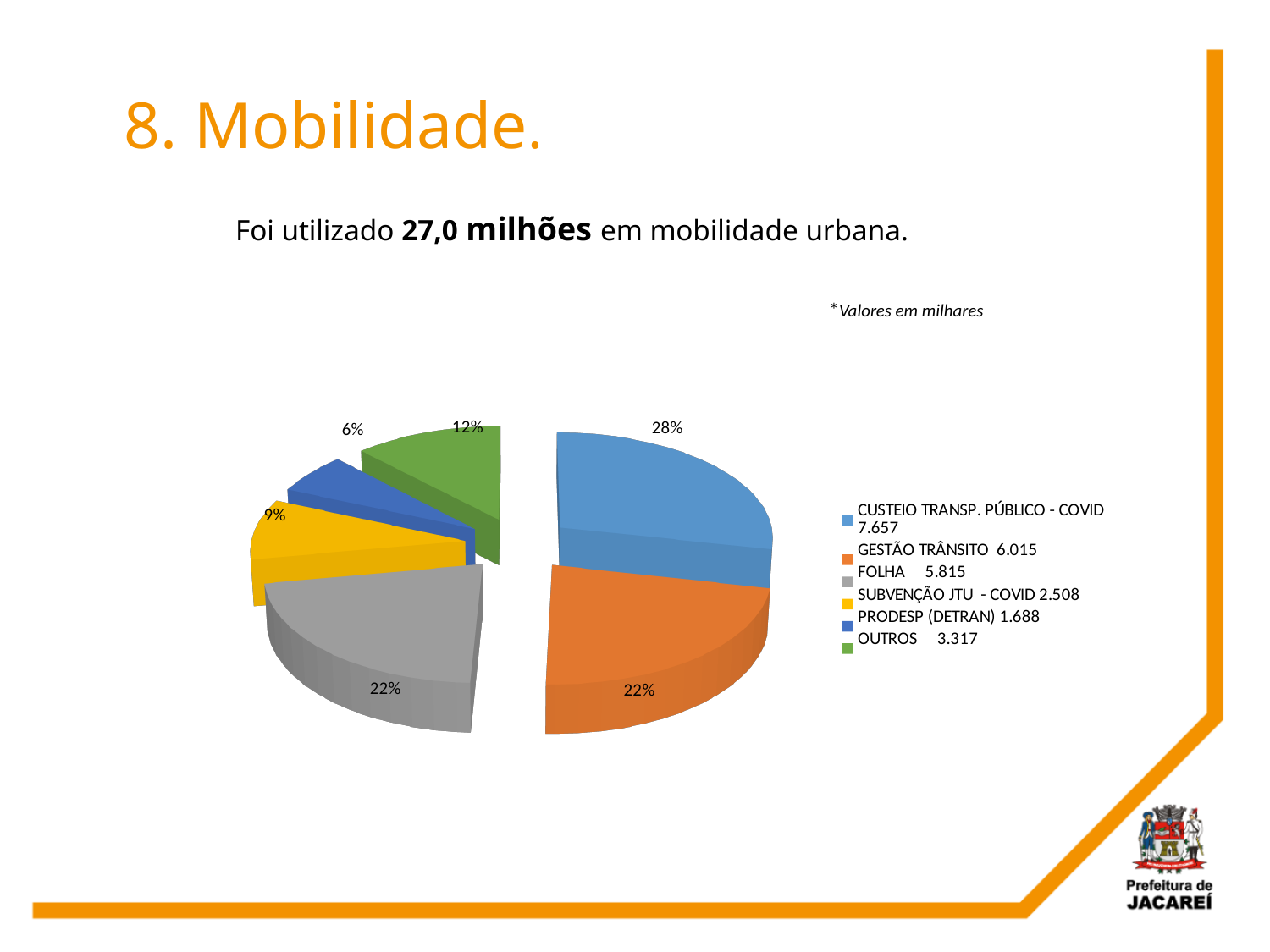
What kind of chart is shown on the slide? pie chart What percentage share of the pie does OUTROS represent? 12% Which category has the largest share of the pie? CUSTEIO TRANSP. PÚBLICO - COVID Which is larger, the value for OUTROS or the value for SUBVENÇÃO JTU - COVID? OUTROS What value is listed in the legend for GESTÃO TRÂNSITO? 6.015 What colour is the slice for OUTROS? green What percentage share of the pie does PRODESP (DETRAN) represent? 6% What percentage share of the pie does CUSTEIO TRANSP. PÚBLICO - COVID represent? 28% What value is listed in the legend for FOLHA? 5.815 How many slices does the pie chart have? 6 Which category has the smallest share of the pie? PRODESP (DETRAN)